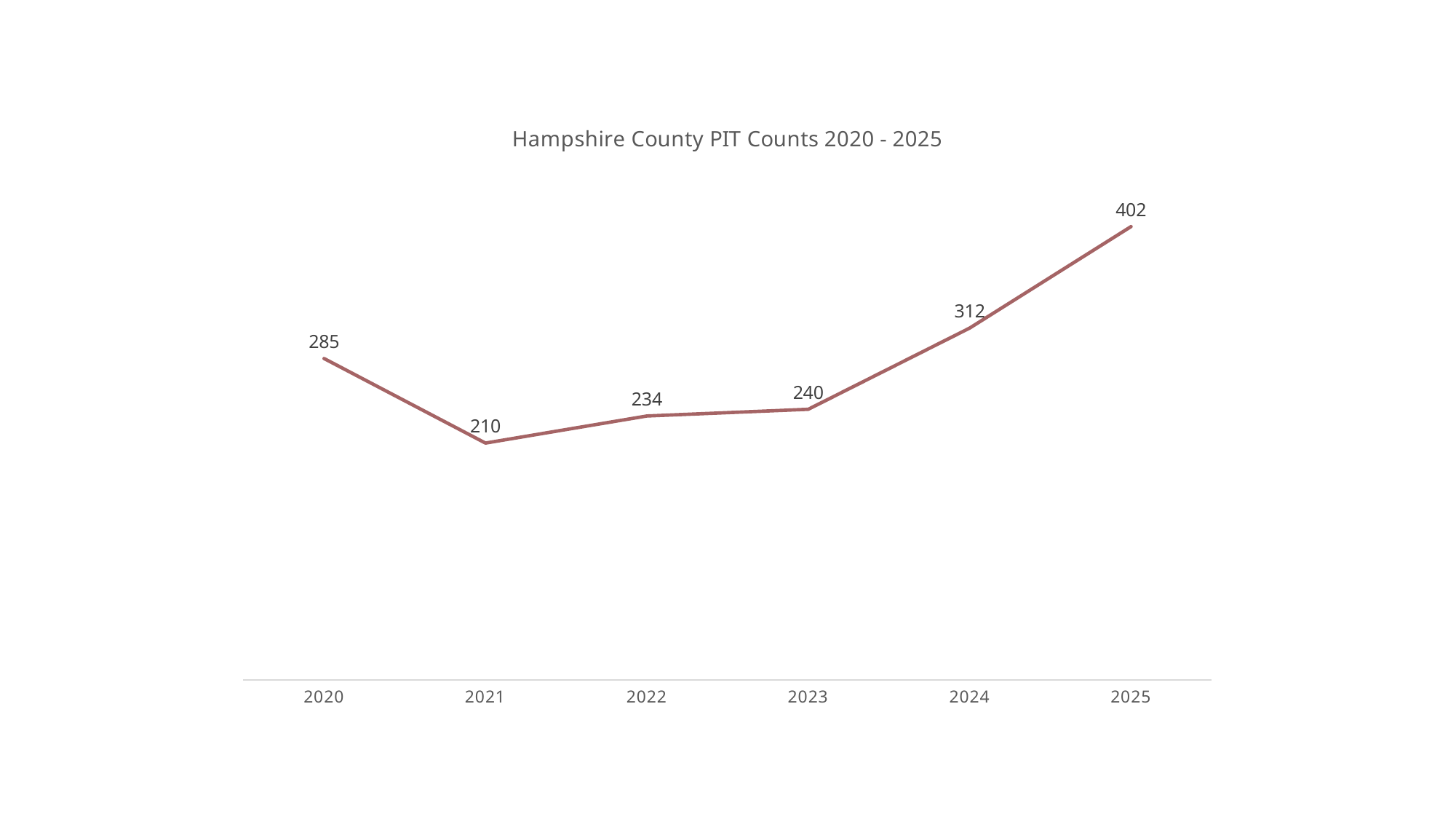
What is the PIT count for 2023? 240 What is the difference between the PIT counts for 2025 and 2024? 90 What is the title of the chart? Hampshire County PIT Counts 2020 - 2025 What is the PIT count for 2020? 285 Do the PIT counts rise or fall from 2021 to 2025? Rise What is the PIT count for 2025? 402 What is the difference between the PIT counts for 2020 and 2021? 75 How many years are plotted on the chart? 6 Which year has the highest PIT count? 2025 Which year has a larger PIT count, 2020 or 2024? 2024 What kind of chart is shown on the slide? Line chart Which year has the lowest PIT count? 2021